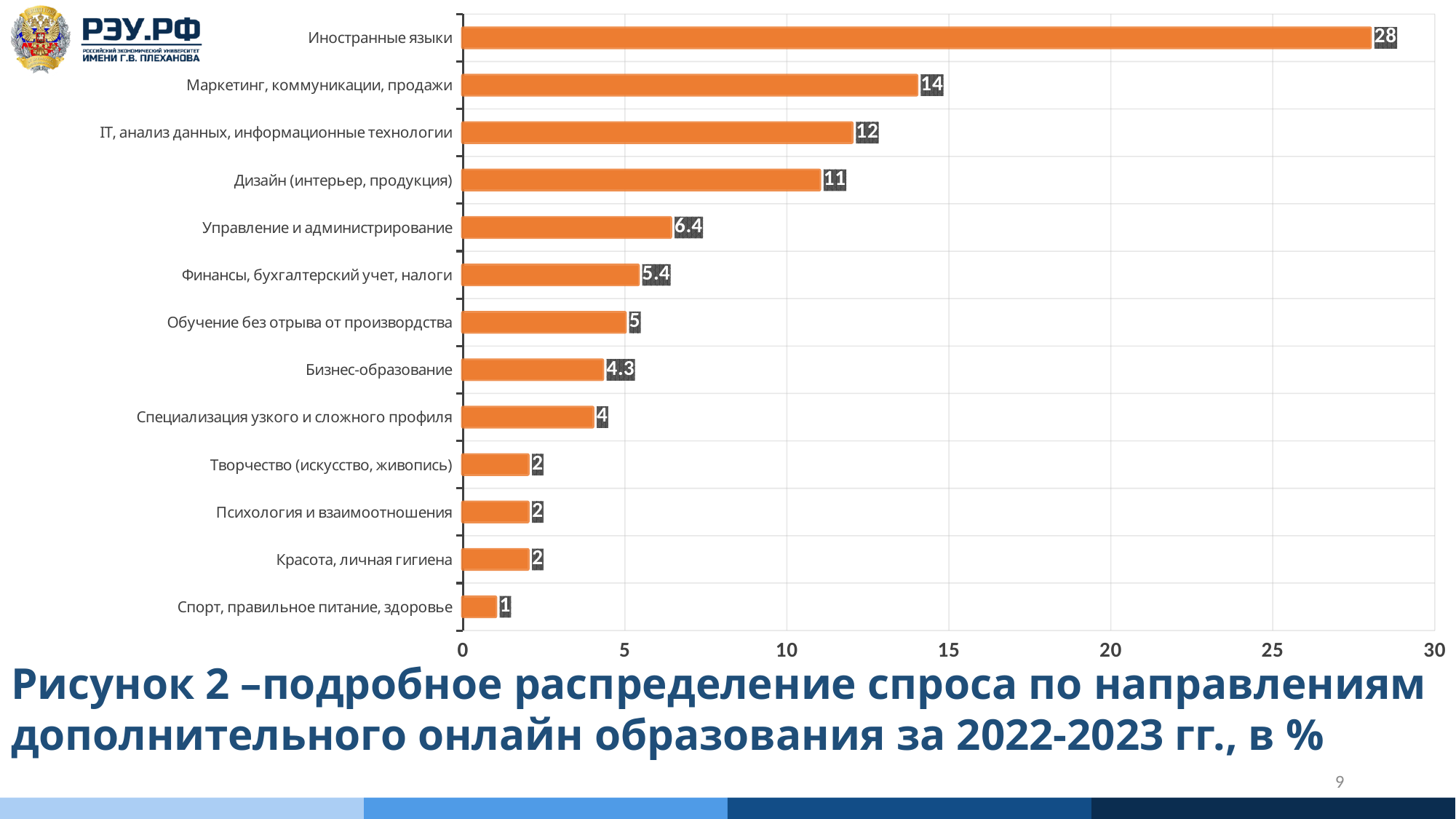
Is the value for Маркетинг, коммуникации, продажи greater or less than 10? greater Which category has the lowest value? Спорт, правильное питание, здоровье What is the value for Иностранные языки? 28 What is the value for Дизайн (интерьер, продукция)? 11 Which is larger, the value for IT, анализ данных, информационные технологии or the value for Дизайн (интерьер, продукция)? IT, анализ данных, информационные технологии Which category has the highest value? Иностранные языки What kind of chart is shown on the slide? bar chart How many categories are shown in the chart? 13 What is the value for Управление и администрирование? 6.4 What is the difference between the values for Финансы, бухгалтерский учет, налоги and Обучение без отрыва от производства? 0.4 What is the difference between the values for Иностранные языки and Маркетинг, коммуникации, продажи? 14 What is the value for Бизнес-образование? 4.3